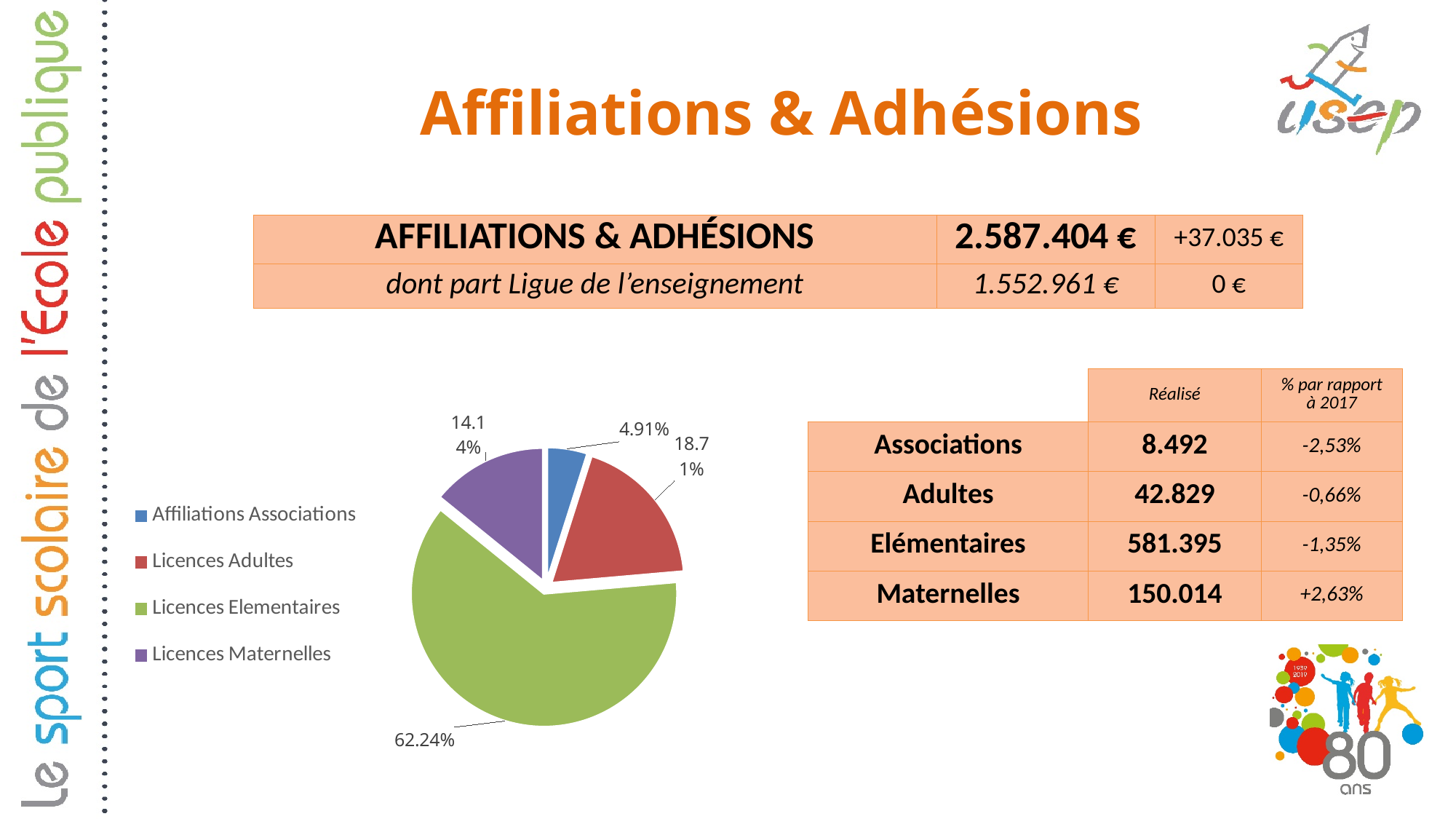
What share of the pie does Licences Elementaires represent? 62.24% In the pie chart, which slice is larger: Licences Adultes or Licences Maternelles? Licences Adultes What percentage does the Licences Elementaires slice show in the pie chart? 62.24% What colour is used for Licences Maternelles in the pie chart legend? Purple Which category has the smallest slice in the pie chart? Affiliations Associations How many entries does the pie chart's legend list? 4 How many slices does the pie chart have? 4 What kind of chart is shown on the slide? Pie chart What colour is the Licences Elementaires slice in the pie chart? Green What percentage does the Affiliations Associations slice show in the pie chart? 4.91% Which category has the largest slice in the pie chart? Licences Elementaires What is the difference in percentage points between the Licences Elementaires slice and the Affiliations Associations slice? 57.33